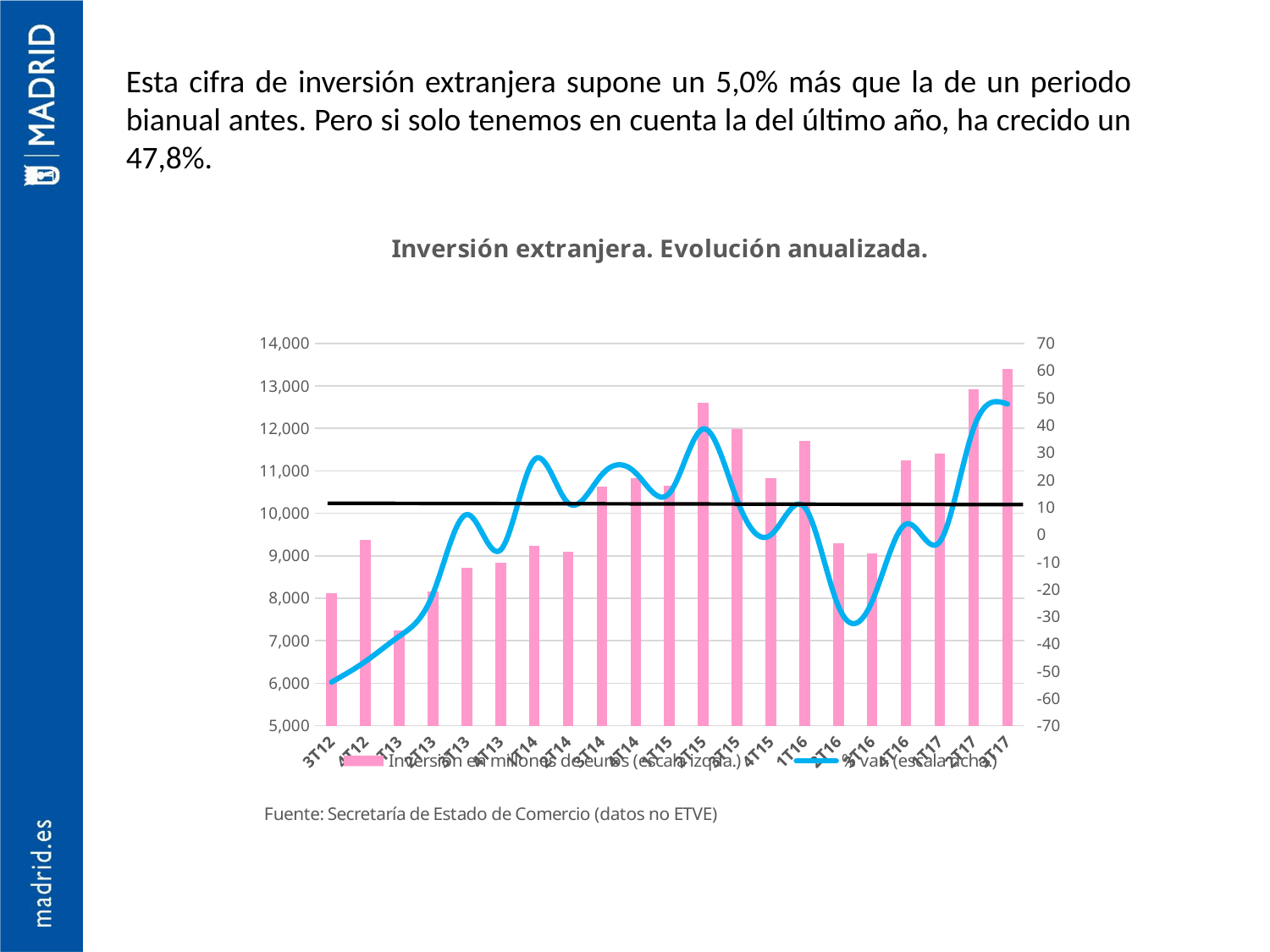
Is the investment bar for 3T16 greater or less than 10,000? less How many quarterly bars are plotted in the chart? 21 Overall, do the investment bars rise or fall from 3T12 to 3T17? rise What kind of chart is shown on the slide? Combination bar and line chart Which has the larger investment bar, 1T16 or 2T16? 1T16 How many series does the legend list? 2 Which quarter has the highest bar for investment in millions of euros? 3T17 Which quarter has the lowest bar for investment in millions of euros? 1T13 Is the investment bar for 2T15 greater or less than 12,000? greater Which quarter has the lowest value on the % var. line? 3T12 What is the title of the chart? Inversión extranjera. Evolución anualizada. Is the investment bar for 1T13 greater or less than 8,000? less